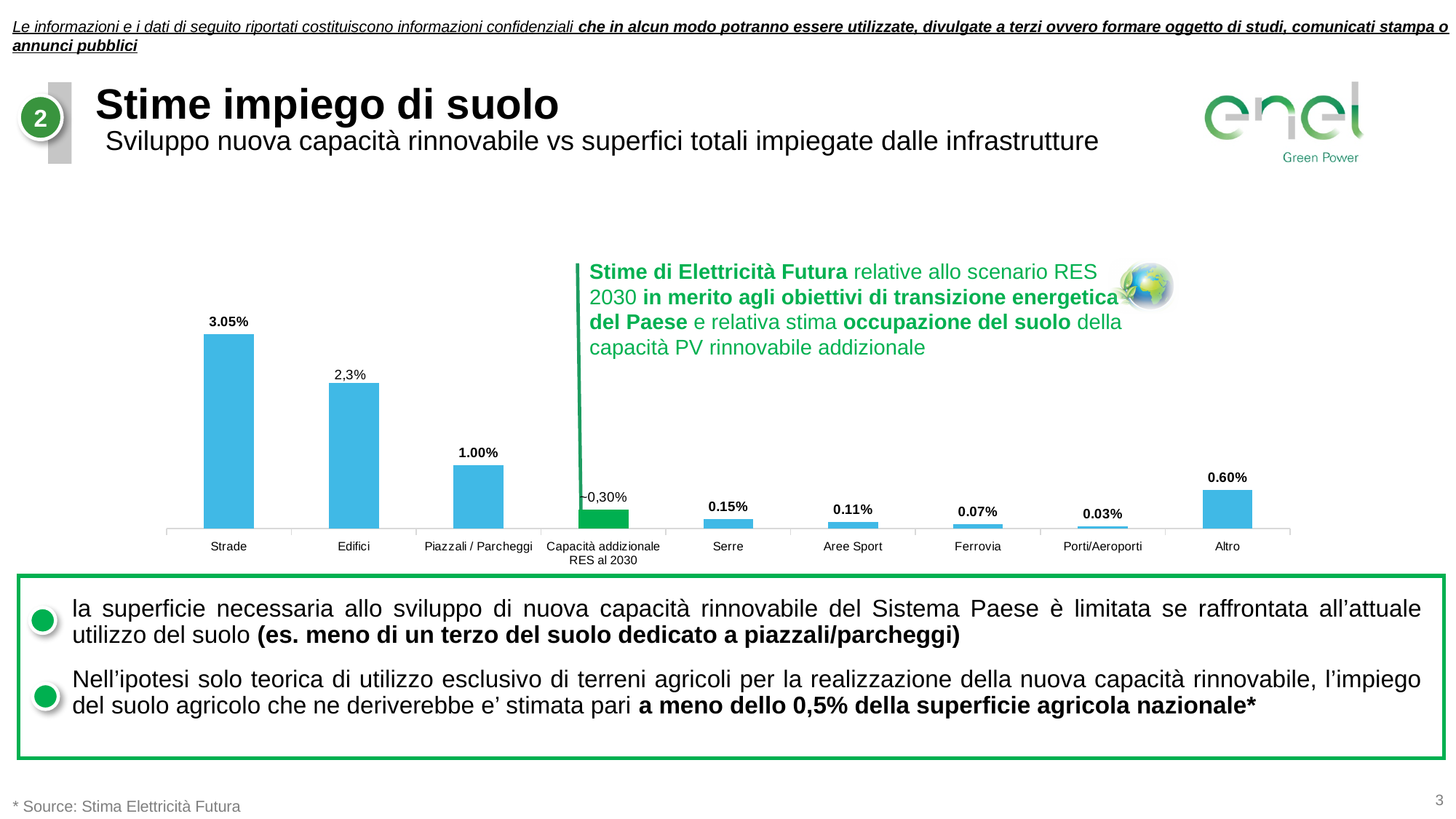
What value is shown for Strade? 3.05% What is the difference between the values for Strade and Piazzali / Parcheggi? 2.05% What value is shown for Piazzali / Parcheggi? 1.00% Which is larger, the value for Altro or the value for Serre? Altro How many categories are shown on the x axis? 9 What value is shown for Altro? 0.60% What colour is the bar for Capacità addizionale RES al 2030? Green What value is shown for Edifici? 2,3% Which category has the highest value? Strade Which category has the lowest value? Porti/Aeroporti What value is shown for Ferrovia? 0.07% What kind of chart is shown on the slide? Bar chart